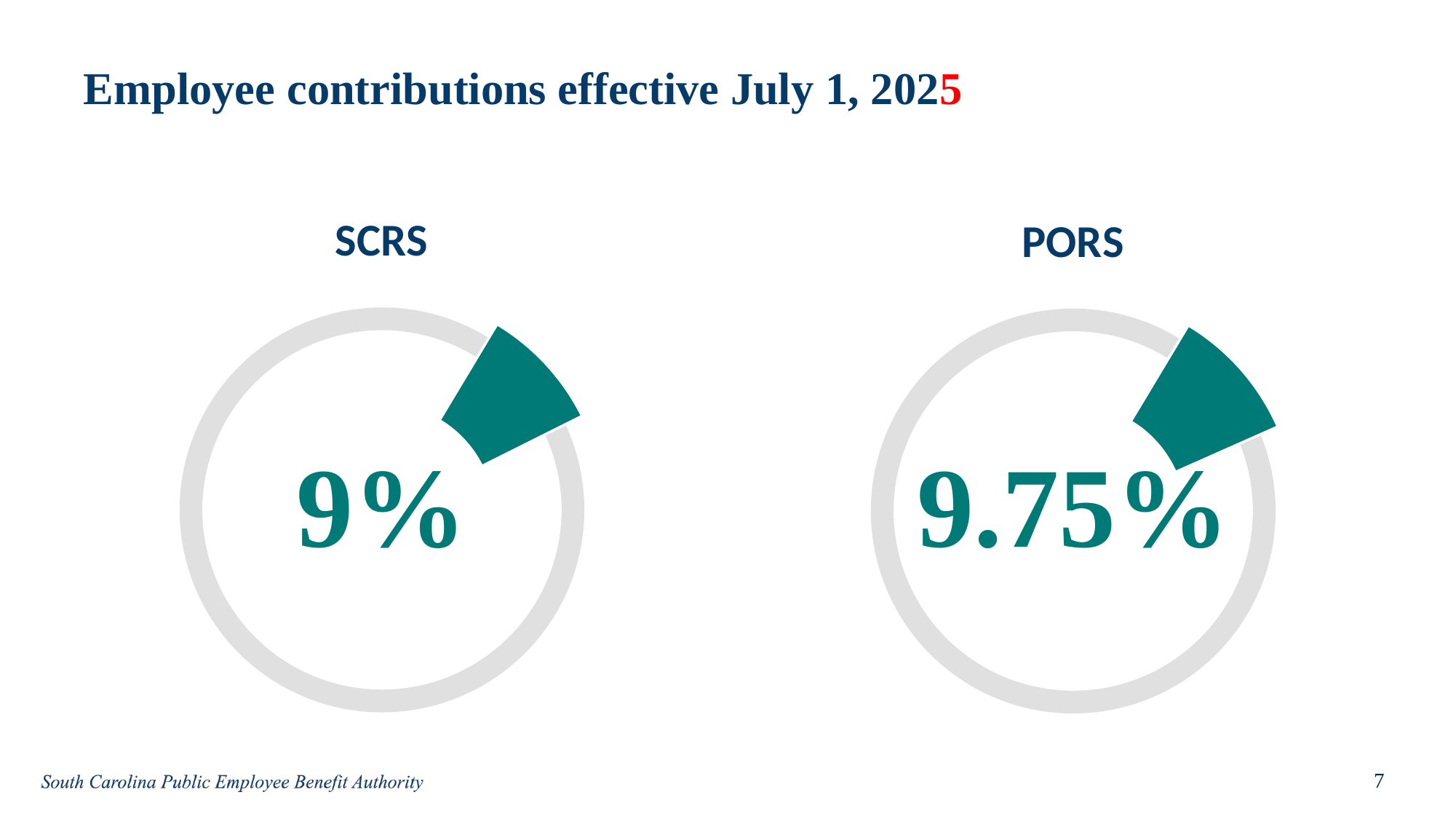
What kind of chart is used to show the SCRS contribution rate? Doughnut chart Which plan shows the higher employee contribution rate, SCRS or PORS? PORS Which of the two charts shows the lower contribution rate? SCRS What is the title of the slide containing the SCRS and PORS charts? Employee contributions effective July 1, 2025 How many charts are shown on the slide? 2 What is the employee contribution rate shown in the PORS chart? 9.75% What is the difference between the PORS rate and the SCRS rate? 0.75% Is the value shown in the PORS chart greater or less than 10%? less What colour is the filled segment in the SCRS chart? Teal What is the employee contribution rate shown in the SCRS chart? 9% Which of the two charts shows the highest contribution rate? PORS